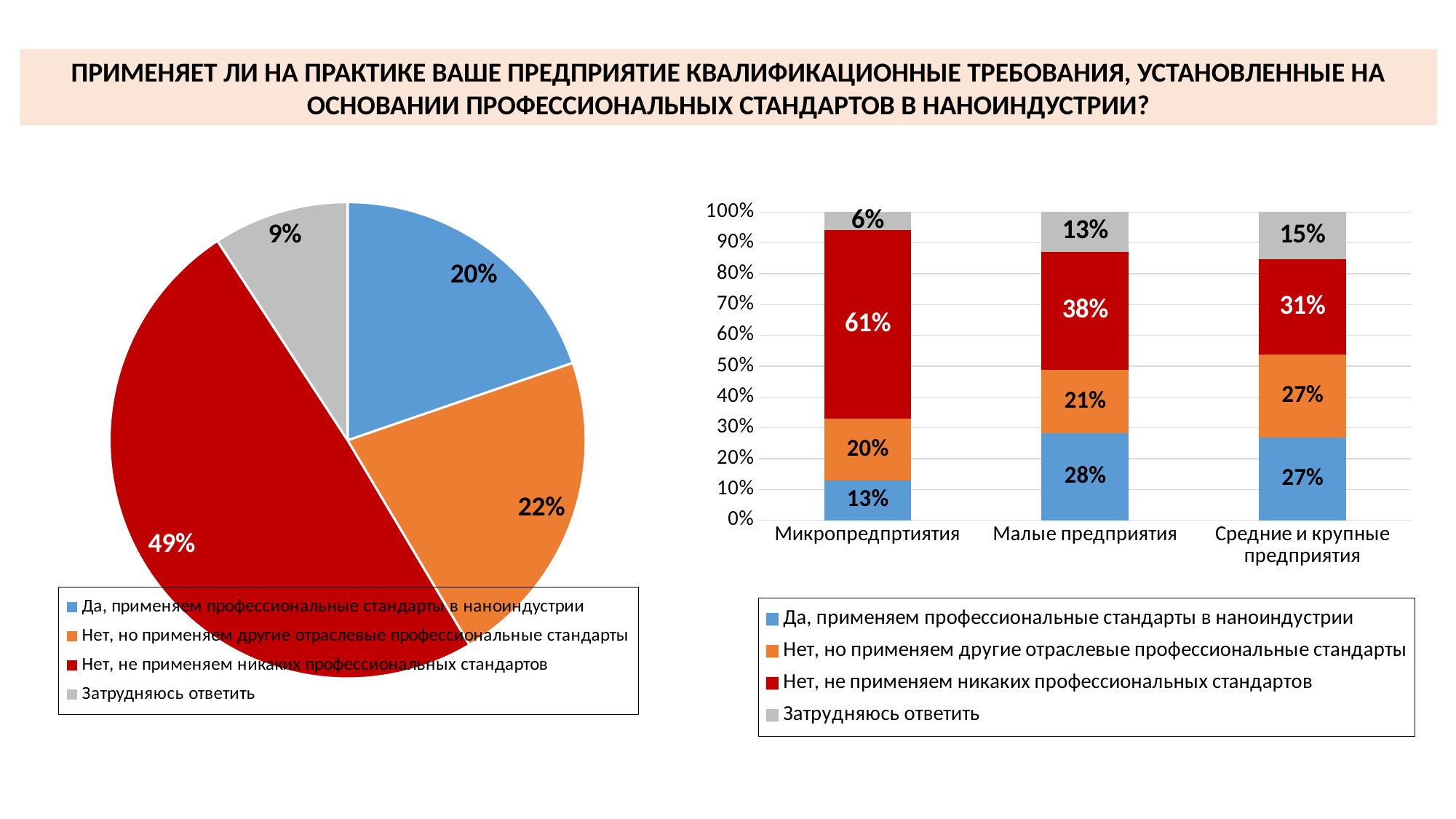
In the stacked bar chart on the right, which is larger: the "Нет, но применяем другие отраслевые профессиональные стандарты" value for Малые предприятия or for Средние и крупные предприятия? Средние и крупные предприятия In the stacked bar chart on the right, which category has the highest value for "Да, применяем профессиональные стандарты в наноиндустрии"? Малые предприятия In the stacked bar chart on the right, what is the difference between the "Нет, не применяем никаких профессиональных стандартов" values for Микропредпртиятия and Малые предприятия? 23% In the stacked bar chart on the right, what is the value for "Нет, не применяем никаких профессиональных стандартов" for Микропредпртиятия? 61% How many categories are shown on the x axis of the stacked bar chart on the right? 3 In the pie chart on the left, what share of respondents answered "Да, применяем профессиональные стандарты в наноиндустрии"? 20% In the pie chart on the left, which answer has the largest slice? Нет, не применяем никаких профессиональных стандартов In the pie chart on the left, which answer has the smallest slice? Затрудняюсь ответить What type of chart is shown on the right side of the slide? Stacked bar chart In the pie chart on the left, what is the difference between the share for "Нет, не применяем никаких профессиональных стандартов" and the share for "Нет, но применяем другие отраслевые профессиональные стандарты"? 27% How many series does the legend of the stacked bar chart on the right list? 4 In the stacked bar chart on the right, what is the value for "Затрудняюсь ответить" for Средние и крупные предприятия? 15%